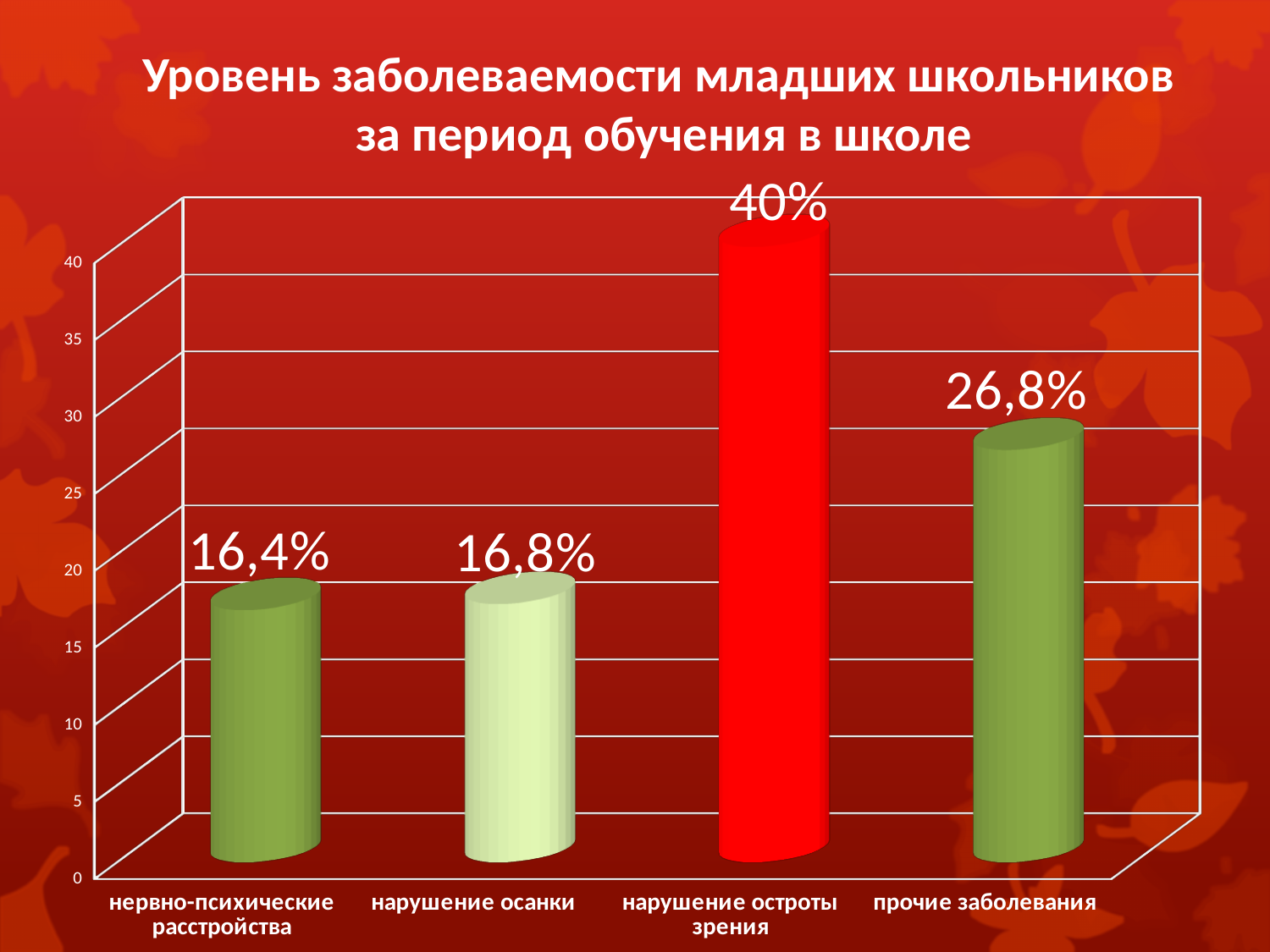
Which is larger, the value for нарушение осанки or the value for нервно-психические расстройства? нарушение осанки Which category has the lowest value? нервно-психические расстройства Is the value for прочие заболевания greater or less than 30? less What is the value for прочие заболевания? 26,8% What is the title of the chart? Уровень заболеваемости младших школьников за период обучения в школе What kind of chart is shown on the slide? bar chart What is the difference between the values for прочие заболевания and нервно-психические расстройства? 10,4% How many categories are shown in the chart? 4 What is the value for нарушение остроты зрения? 40% What is the value for нервно-психические расстройства? 16,4% What is the difference between the values for нарушение остроты зрения and прочие заболевания? 13,2% Which category has the highest value? нарушение остроты зрения